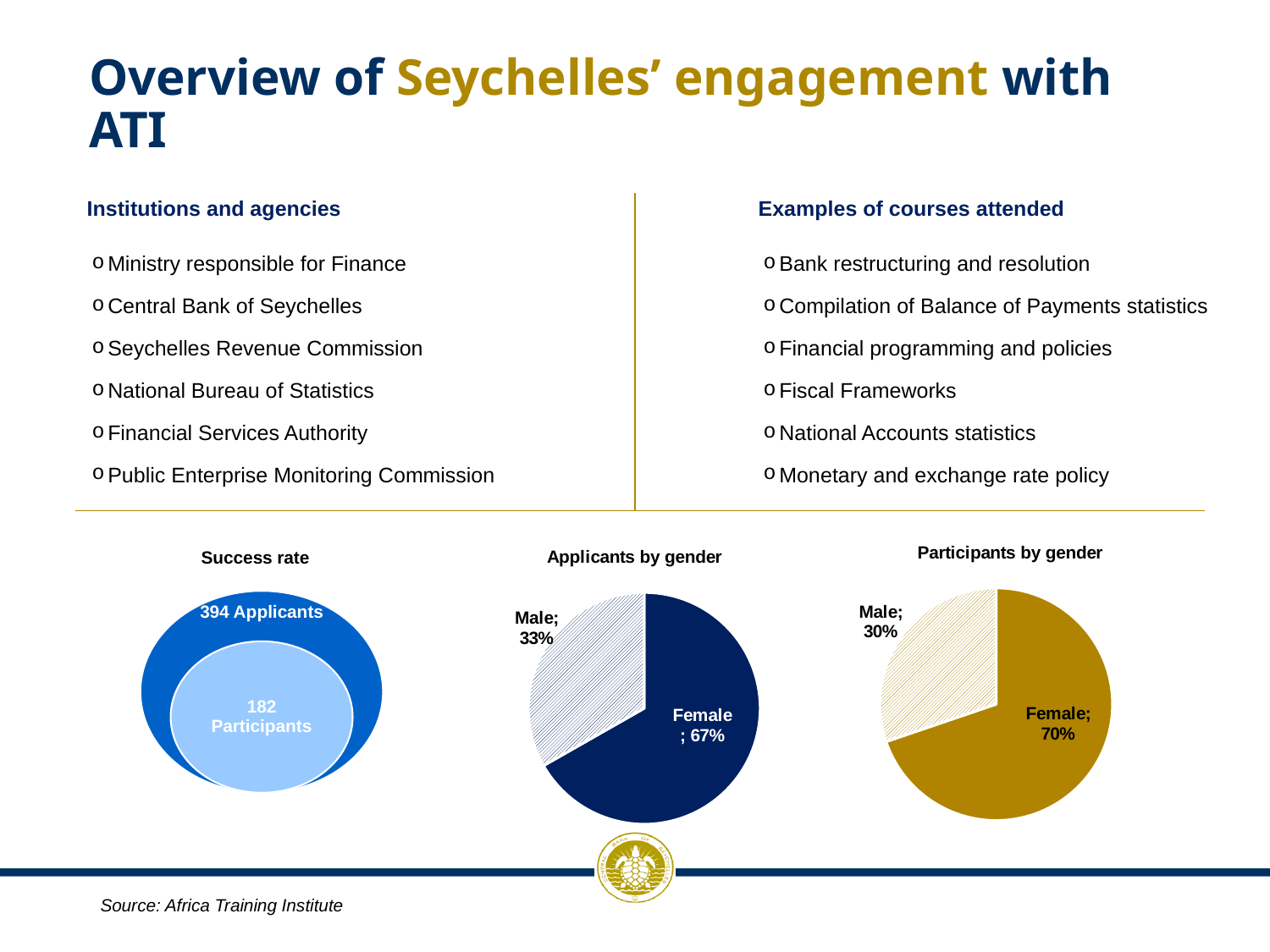
How many slices does the 'Participants by gender' pie chart have? 2 In the 'Success rate' diagram, how many participants are shown? 182 Participants What kind of chart is the 'Applicants by gender' chart? Pie chart In the 'Applicants by gender' chart, what is the difference in percentage points between the female and male shares? 34 percentage points Is the male share larger in the 'Applicants by gender' chart or in the 'Participants by gender' chart? Applicants by gender In the 'Participants by gender' chart, what share of participants is female? 70% In the 'Participants by gender' chart, what share of participants is male? 30% In the 'Participants by gender' chart, which category has the largest slice? Female In the 'Applicants by gender' chart, what share of applicants is male? 33% In the 'Success rate' diagram, how many applicants are shown? 394 Applicants In the 'Applicants by gender' chart, which category has the smallest slice? Male In the 'Applicants by gender' chart, what share of applicants is female? 67%